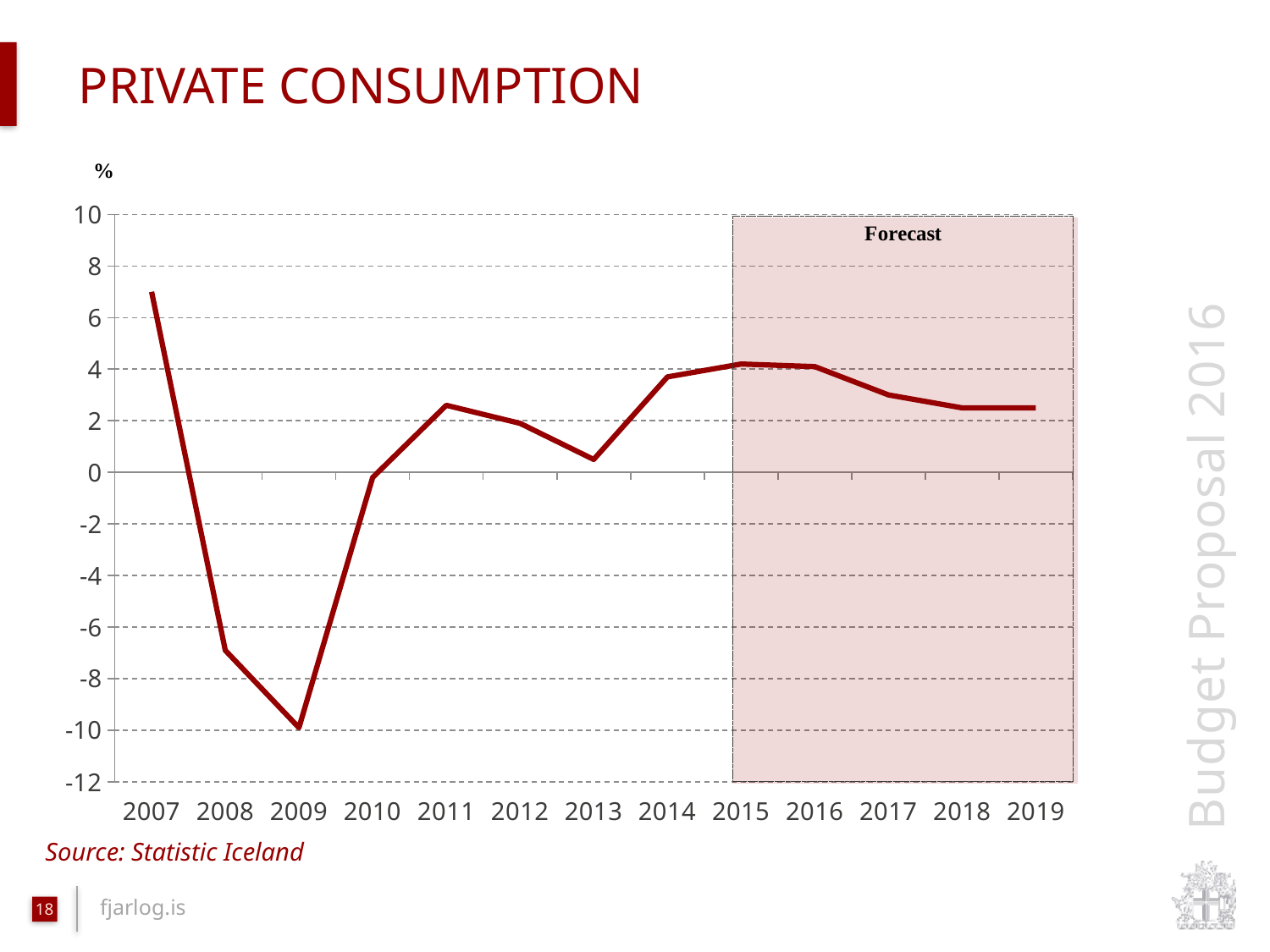
Which year has the larger value, 2011 or 2013? 2011 Is the value for 2007 greater or less than 6? greater Is the value for 2014 greater or less than 2? greater Do the values rise or fall from 2007 to 2009? fall Do the values rise or fall from 2013 to 2015? rise What kind of chart is shown on the slide? line chart From which year does the shaded Forecast area begin? 2015 Is the value for 2013 greater or less than 2? less How many years are shown on the x axis? 13 Which year has the highest private consumption growth? 2007 Which year has the lowest private consumption growth? 2009